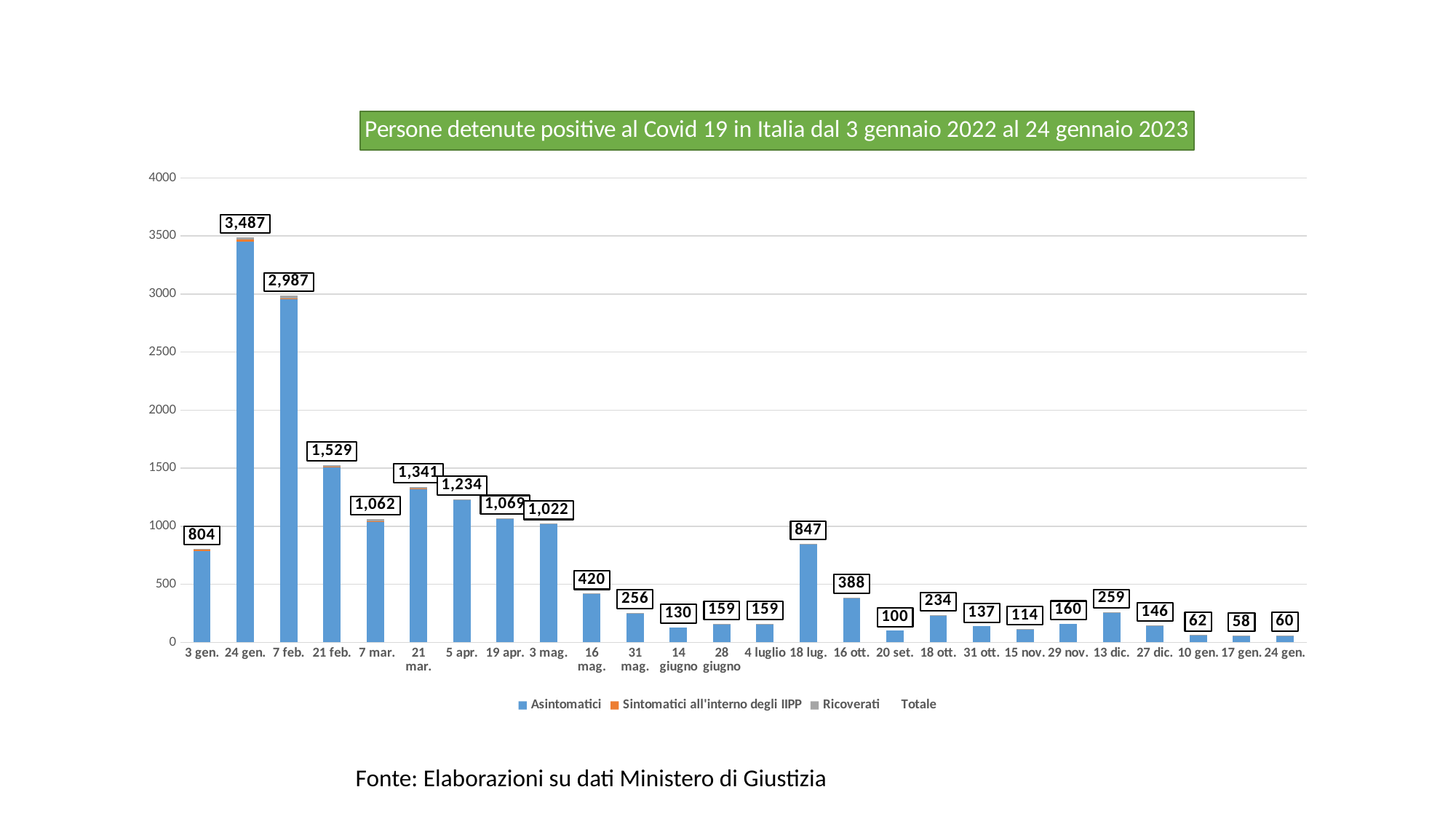
How many entries does the legend list? 4 Which has a larger total, 16 mag. or 16 ott.? 16 mag. Is the total for 7 feb. greater or less than 3000? less What is the total value labelled for 24 gen. at the far right of the chart (January 2023)? 60 What is the difference between the totals for 24 gen. (3,487) and 7 feb. (2,987)? 500 Which date has the highest total? 24 gen. What is the total value labelled for 21 feb.? 1,529 What kind of chart is shown on the slide? bar chart How many dates are shown on the x axis? 26 Do the totals rise or fall from 24 gen. to 3 mag.? fall Which date has the lowest total? 17 gen. What is the total value labelled for 18 lug.? 847